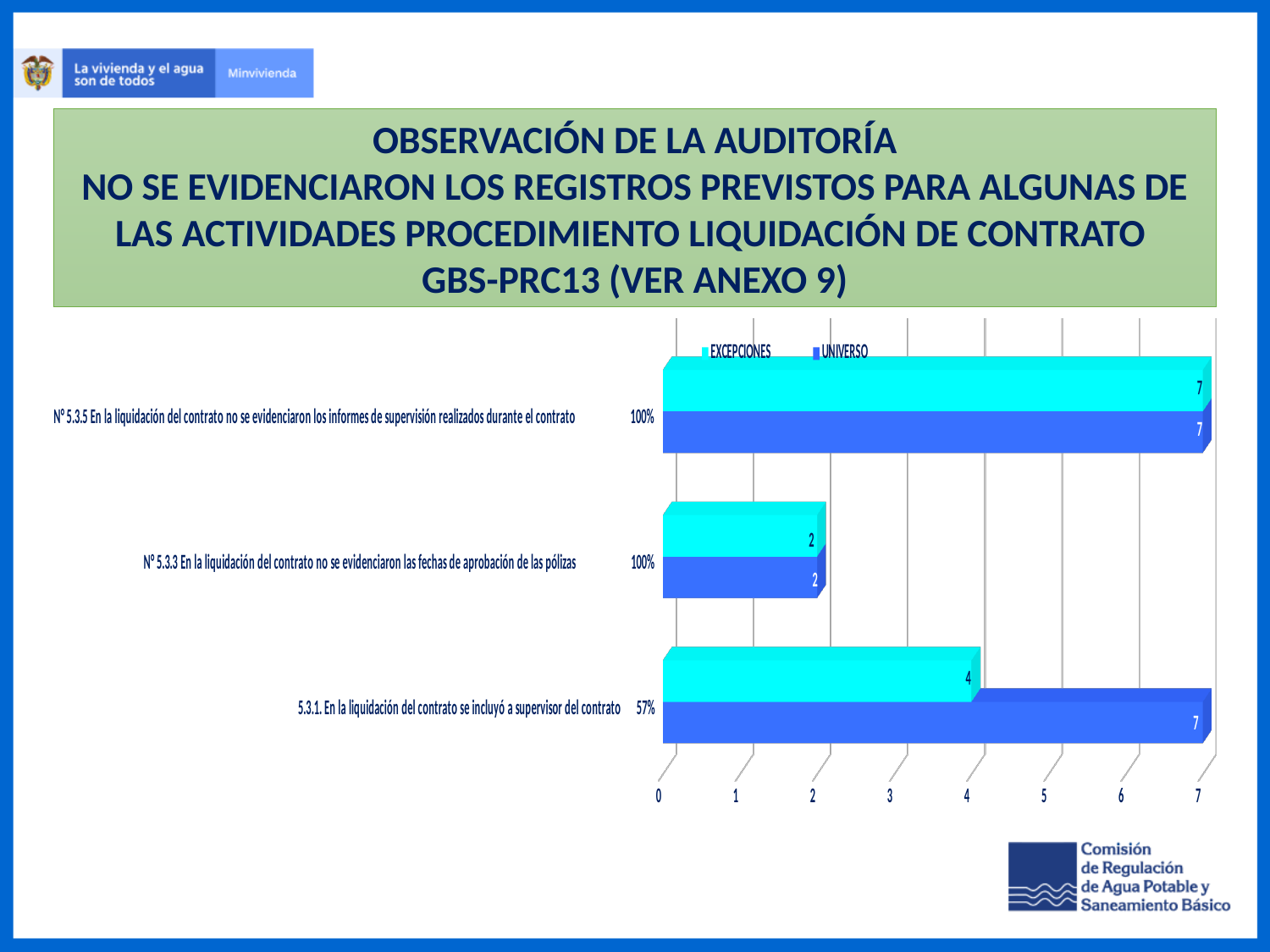
What is the EXCEPCIONES value for the category 'N° 5.3.3 En la liquidación del contrato no se evidenciaron las fechas de aprobación de las pólizas'? 2 What percentage is shown next to the category '5.3.1. En la liquidación del contrato se incluyó a supervisor del contrato'? 57% For the category 'N° 5.3.3 En la liquidación del contrato no se evidenciaron las fechas de aprobación de las pólizas', is the EXCEPCIONES value greater or less than 4? less What type of chart is shown on the slide? bar chart How many categories are plotted in the chart? 3 What is the UNIVERSO value for the category 'N° 5.3.5 En la liquidación del contrato no se evidenciaron los informes de supervisión realizados durante el contrato'? 7 What is the UNIVERSO value for the category '5.3.1. En la liquidación del contrato se incluyó a supervisor del contrato'? 7 What is the difference between the UNIVERSO and EXCEPCIONES values for the category '5.3.1. En la liquidación del contrato se incluyó a supervisor del contrato'? 3 Which category has the lowest UNIVERSO value? N° 5.3.3 En la liquidación del contrato no se evidenciaron las fechas de aprobación de las pólizas Which series is shown in cyan in the chart legend? EXCEPCIONES How many series does the chart legend list? 2 What is the EXCEPCIONES value for the category '5.3.1. En la liquidación del contrato se incluyó a supervisor del contrato'? 4